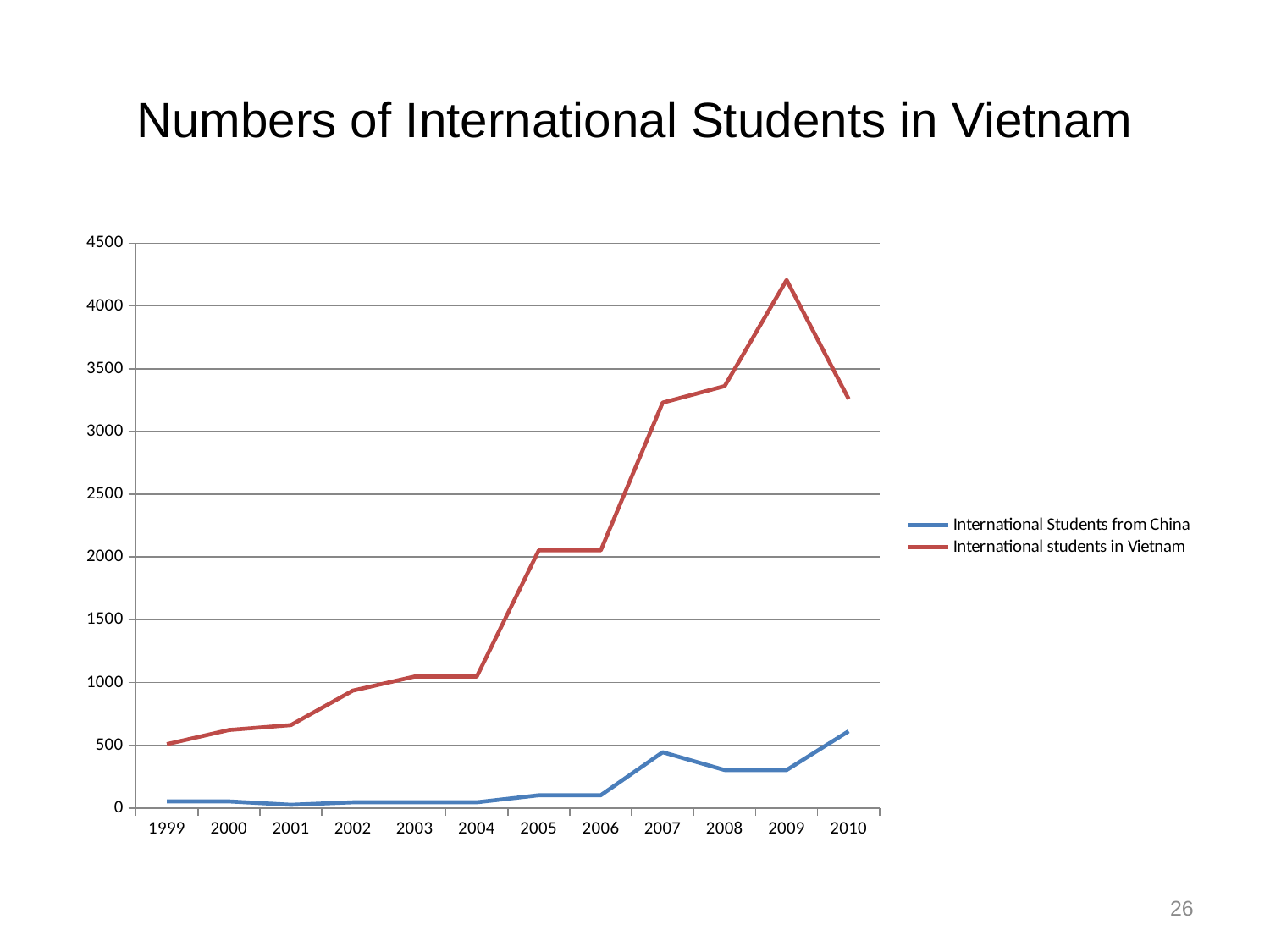
Is the value for International students in Vietnam in 2009 greater or less than 4000? greater How many years are plotted along the x axis? 12 In which year is the number of International students in Vietnam highest? 2009 Which year has more International students in Vietnam, 2009 or 2010? 2009 What kind of chart is shown on the slide? Line chart In which year is the number of International students in Vietnam lowest? 1999 How many series does the legend list? 2 Is the value for International Students from China in 2008 greater or less than 500? less Does the number of International students in Vietnam rise or fall between 2009 and 2010? fall What is the title of the chart? Numbers of International Students in Vietnam Is the value for International students in Vietnam in 2007 greater or less than 3000? greater In which year is the number of International Students from China highest? 2010